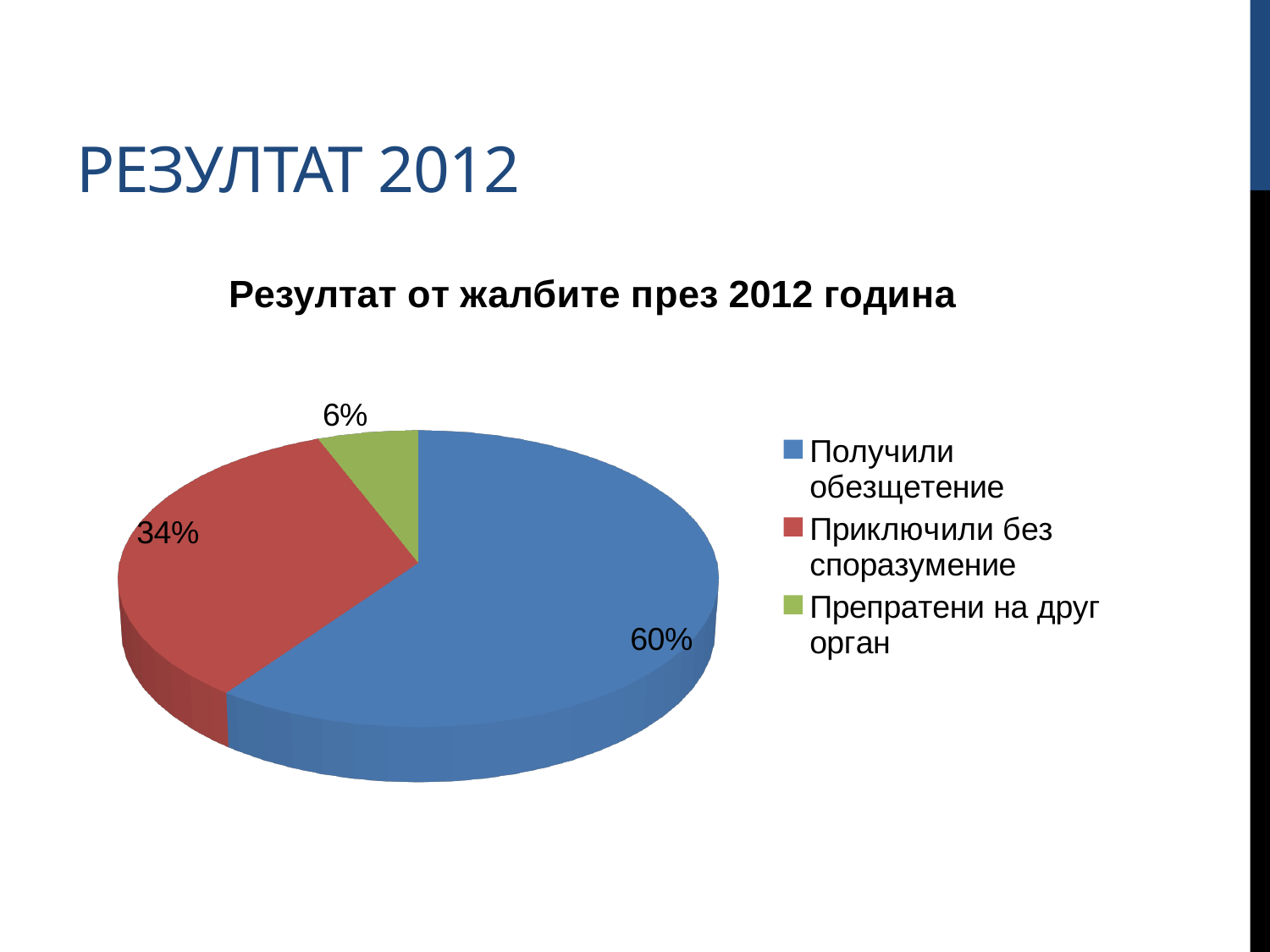
What share of the pie is labelled 'Приключили без споразумение'? 34% What is the chart's title? Резултат от жалбите през 2012 година What kind of chart is shown on the slide? pie chart Which category has the smallest slice of the pie? Препратени на друг орган What is the difference between the shares for 'Приключили без споразумение' and 'Препратени на друг орган'? 28% Which is larger: the share for 'Приключили без споразумение' or for 'Препратени на друг орган'? Приключили без споразумение What share of the pie is labelled 'Препратени на друг орган'? 6% What is the difference between the shares for 'Получили обезщетение' and 'Приключили без споразумение'? 26% How many categories does the pie chart have? 3 Which category has the largest slice of the pie? Получили обезщетение What colour is the slice for 'Препратени на друг орган'? green What share of the pie is labelled 'Получили обезщетение'? 60%